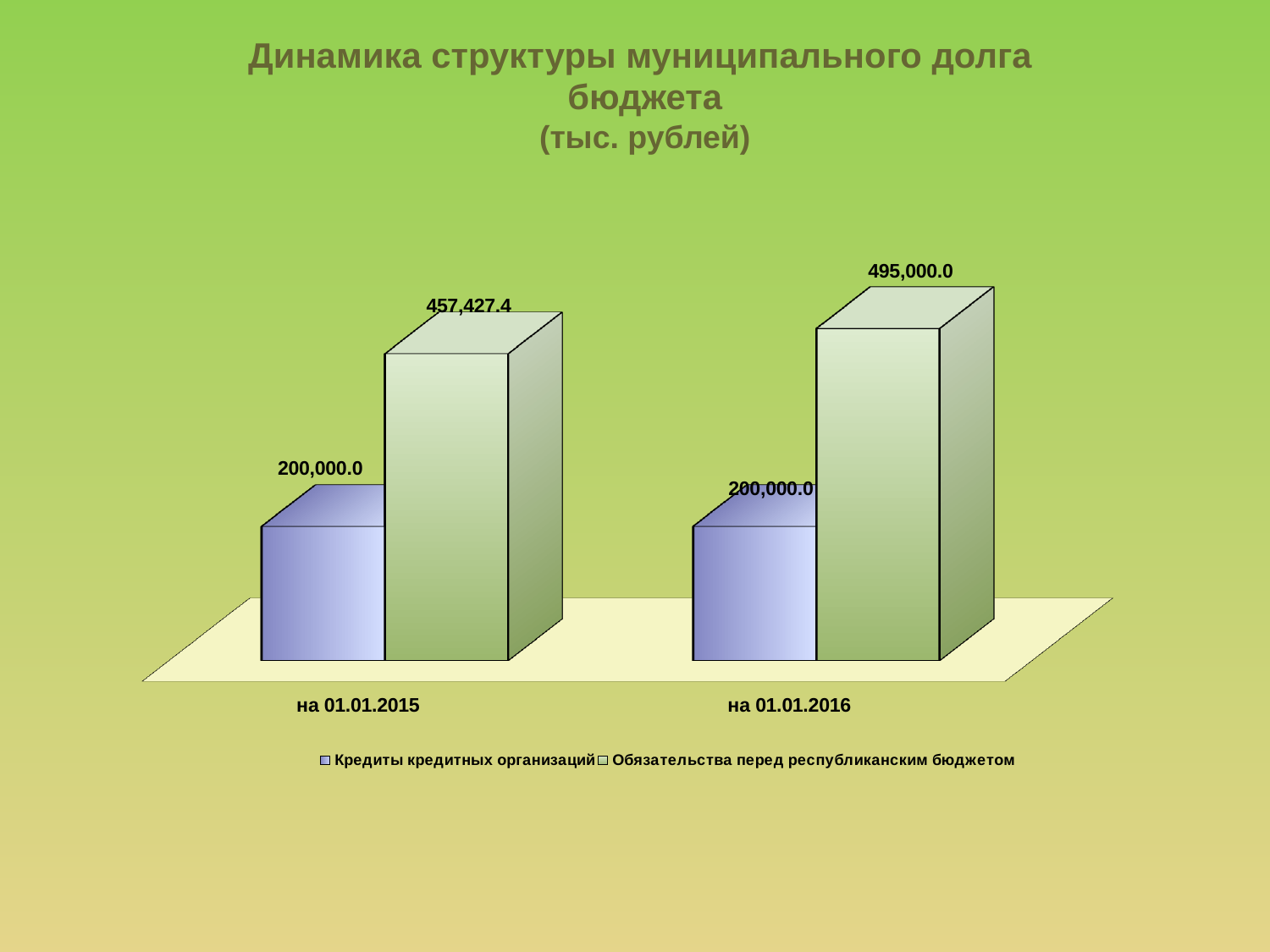
What unit is given in the chart title? тыс. рублей Does the value for Обязательства перед республиканским бюджетом rise or fall from 01.01.2015 to 01.01.2016? rise What is the value for Кредиты кредитных организаций на 01.01.2016? 200,000.0 How many categories are shown on the x axis? 2 What is the value for Обязательства перед республиканским бюджетом на 01.01.2016? 495,000.0 What is the difference between Обязательства перед республиканским бюджетом на 01.01.2016 and на 01.01.2015? 37,572.6 What is the value for Кредиты кредитных организаций на 01.01.2015? 200,000.0 What is the difference between Обязательства перед республиканским бюджетом and Кредиты кредитных организаций на 01.01.2015? 257,427.4 Which series has the higher value на 01.01.2016? Обязательства перед республиканским бюджетом What is the value for Обязательства перед республиканским бюджетом на 01.01.2015? 457,427.4 What kind of chart is shown on the slide? bar chart How many series does the legend list? 2